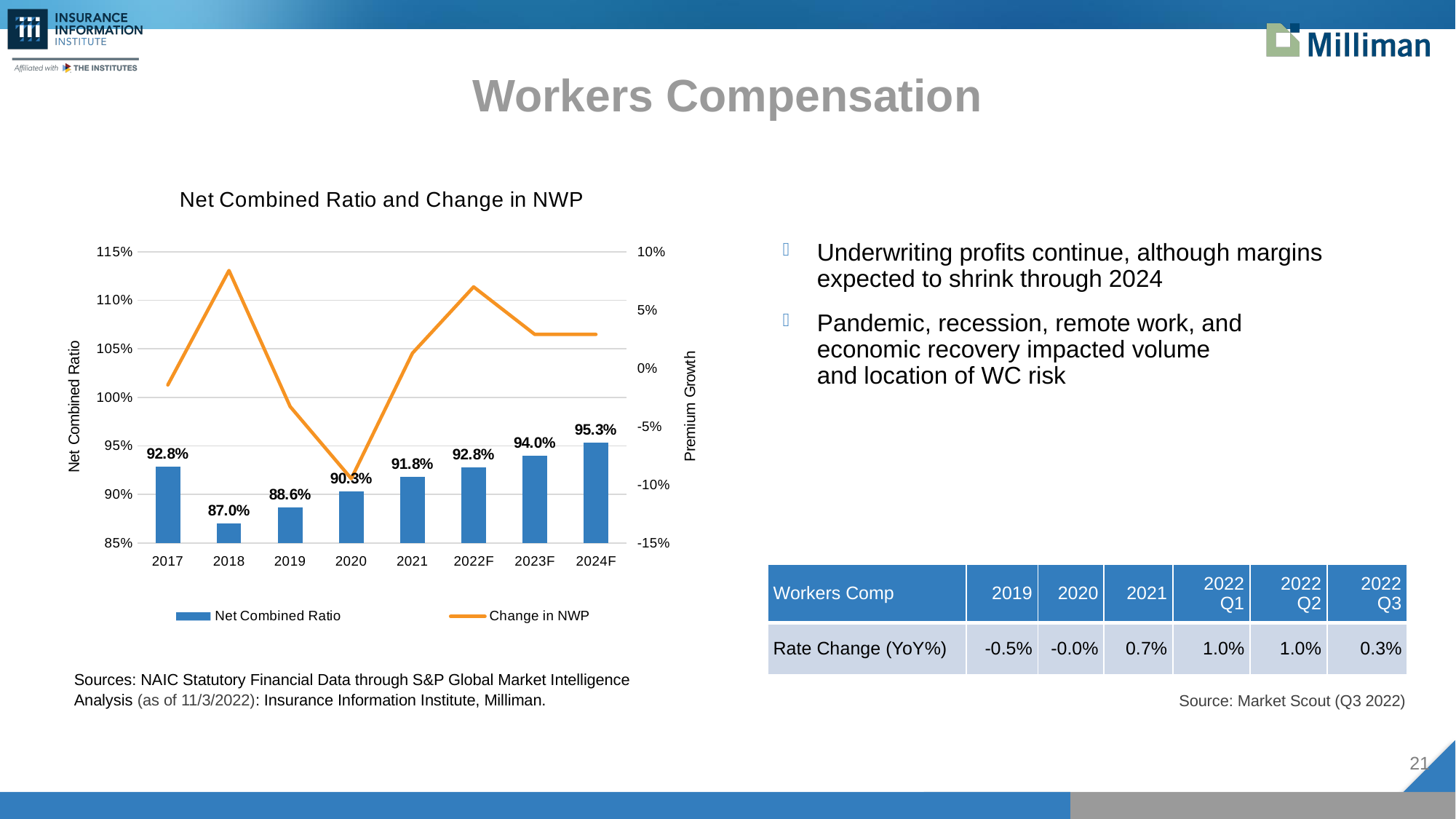
Does the Net Combined Ratio rise or fall from 2018 to 2024F? rise Is the Change in NWP for 2018 greater or less than 5%? greater What is the Net Combined Ratio for 2020? 90.3% How many years are shown on the x axis of the chart? 8 Is the Change in NWP for 2020 greater or less than -5%? less How many series does the chart legend list? 2 Which is larger, the Net Combined Ratio for 2019 or for 2021? 2021 Which year has the highest Net Combined Ratio? 2024F What is the difference between the Net Combined Ratio for 2024F and for 2018? 8.3 percentage points What is the Net Combined Ratio for 2024F? 95.3% What is the Net Combined Ratio for 2018? 87.0% Which year has the lowest Net Combined Ratio? 2018